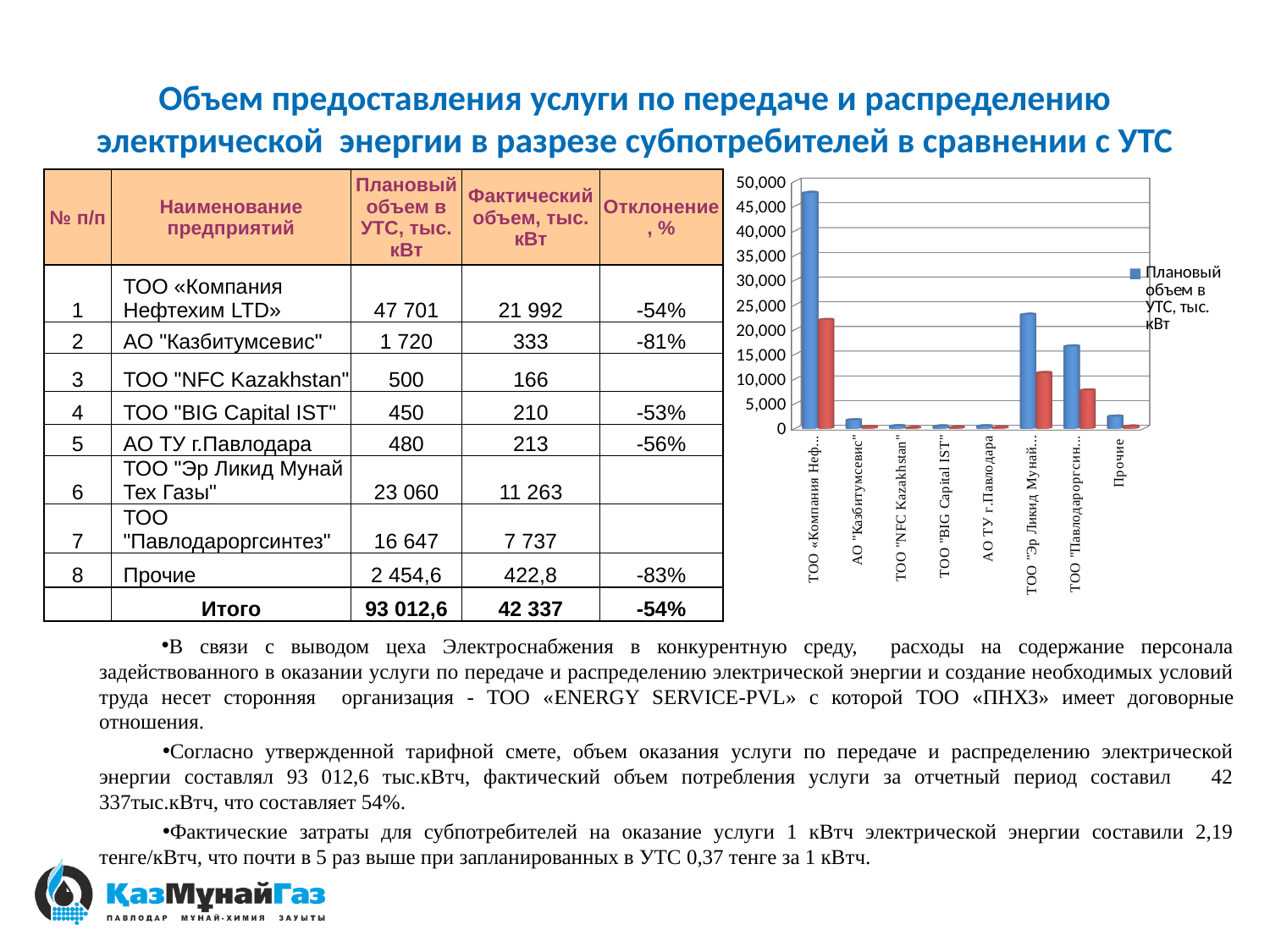
Is the actual volume (red bar) for ТОО "Павлодароргсинтез" greater or less than 10,000? less Which category has the highest planned volume (blue bar) in the chart? ТОО «Компания Нефтехим LTD» What is the actual volume (тыс. кВт) for Прочие? 422,8 What kind of chart is shown on the slide? bar chart Which series does the blue bar represent according to the chart legend? Плановый объем в УТС, тыс. кВт How many enterprise categories are plotted along the x axis of the chart? 8 What is the difference between the planned and actual volume for ТОО «Компания Нефтехим LTD»? 25 709 Is the planned volume (blue bar) for ТОО "Эр Ликид Мунай Тех Газы" greater or less than 20,000? greater Is the planned volume (blue bar) for Прочие greater or less than 5,000? less What is the planned volume in УТС (тыс. кВт) for АО "Казбитумсевис"? 1 720 For ТОО «Компания Нефтехим LTD», which is larger: the planned volume or the actual volume? planned volume Which has the larger planned volume: ТОО "Эр Ликид Мунай Тех Газы" or ТОО "Павлодароргсинтез"? ТОО "Эр Ликид Мунай Тех Газы"